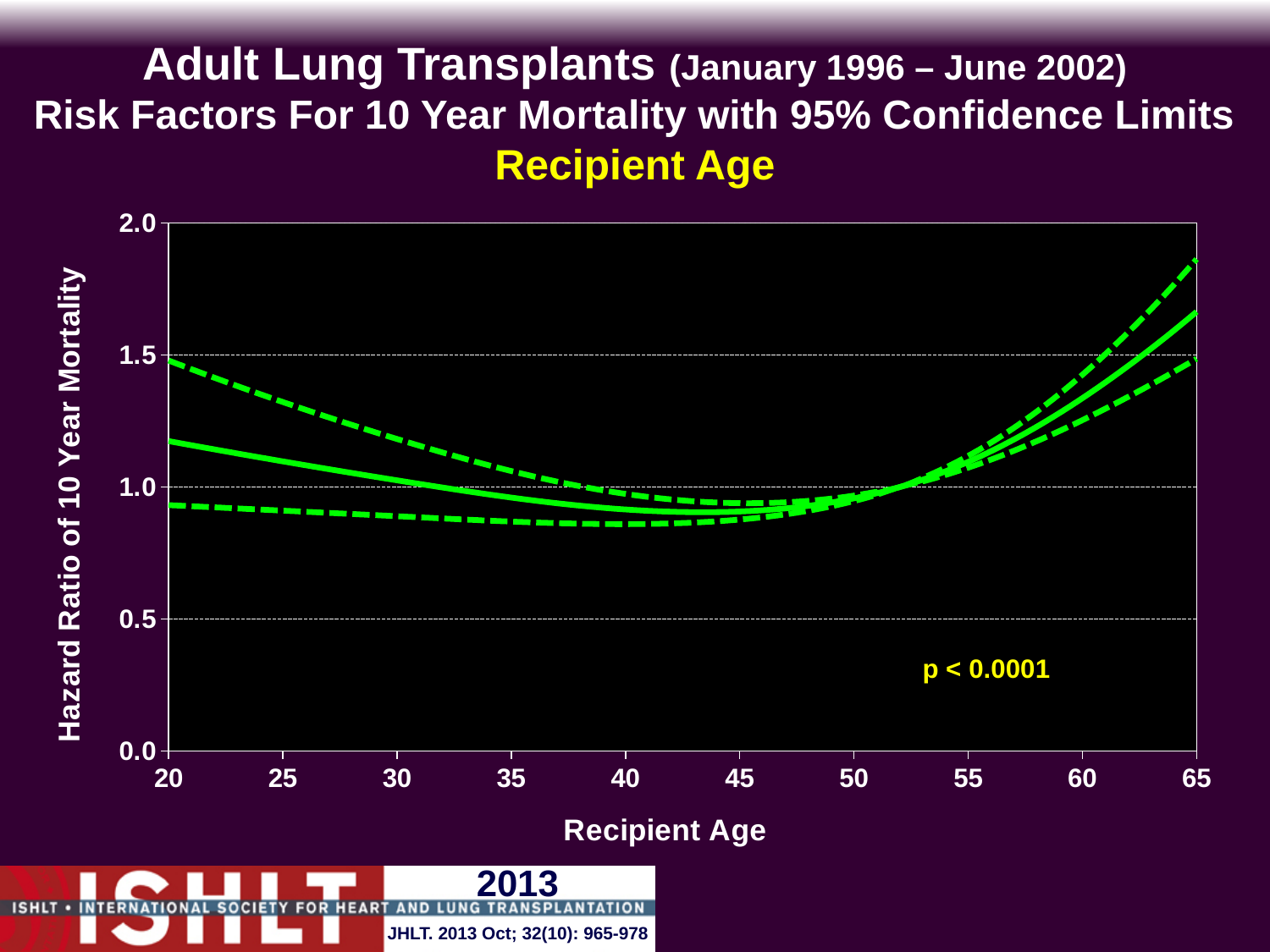
What p-value is printed on the chart? p < 0.0001 Is the upper confidence limit (upper dashed line) at recipient age 20 greater or less than 1.0? greater What is the label of the x axis? Recipient Age What kind of chart is shown on the slide? line chart Is the hazard ratio (solid line) at recipient age 65 greater or less than 1.5? greater How many lines are plotted on the chart? 3 Is the hazard ratio (solid line) at recipient age 20 greater or less than 1.0? greater Does the hazard ratio (solid line) rise or fall as recipient age increases from 20 to 40? fall Which has the larger hazard ratio on the solid line: recipient age 65 or recipient age 20? recipient age 65 Does the hazard ratio (solid line) rise or fall as recipient age increases from 50 to 65? rise What is the label of the y axis? Hazard Ratio of 10 Year Mortality